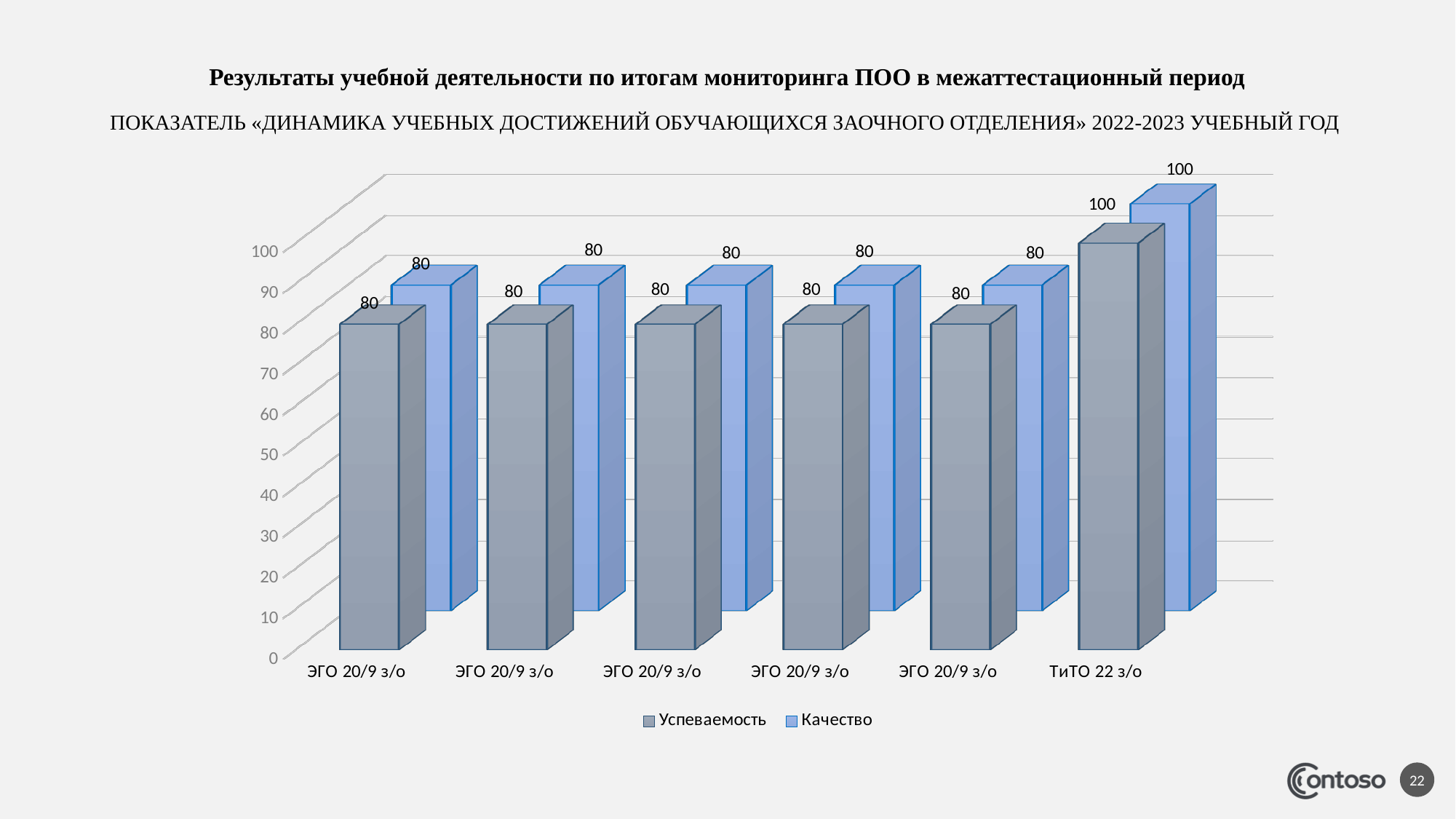
What type of chart is shown on the slide? Bar chart Which category has the highest Успеваемость value? ТиТО 22 з/о How many series does the legend list? 2 Is the Качество value for ТиТО 22 з/о greater or less than 90? greater What are the two series named in the legend? Успеваемость and Качество Which category has the highest Качество value? ТиТО 22 з/о What is the Качество value for ТиТО 22 з/о? 100 How many categories are shown on the x axis? 6 What is the difference between the Успеваемость value for ТиТО 22 з/о and the Успеваемость value for the first ЭГО 20/9 з/о category? 20 Which is larger for ТиТО 22 з/о: Успеваемость or Качество, or are they equal? They are equal What value is shown for Качество in each of the ЭГО 20/9 з/о categories? 80 What is the Успеваемость value for ТиТО 22 з/о? 100